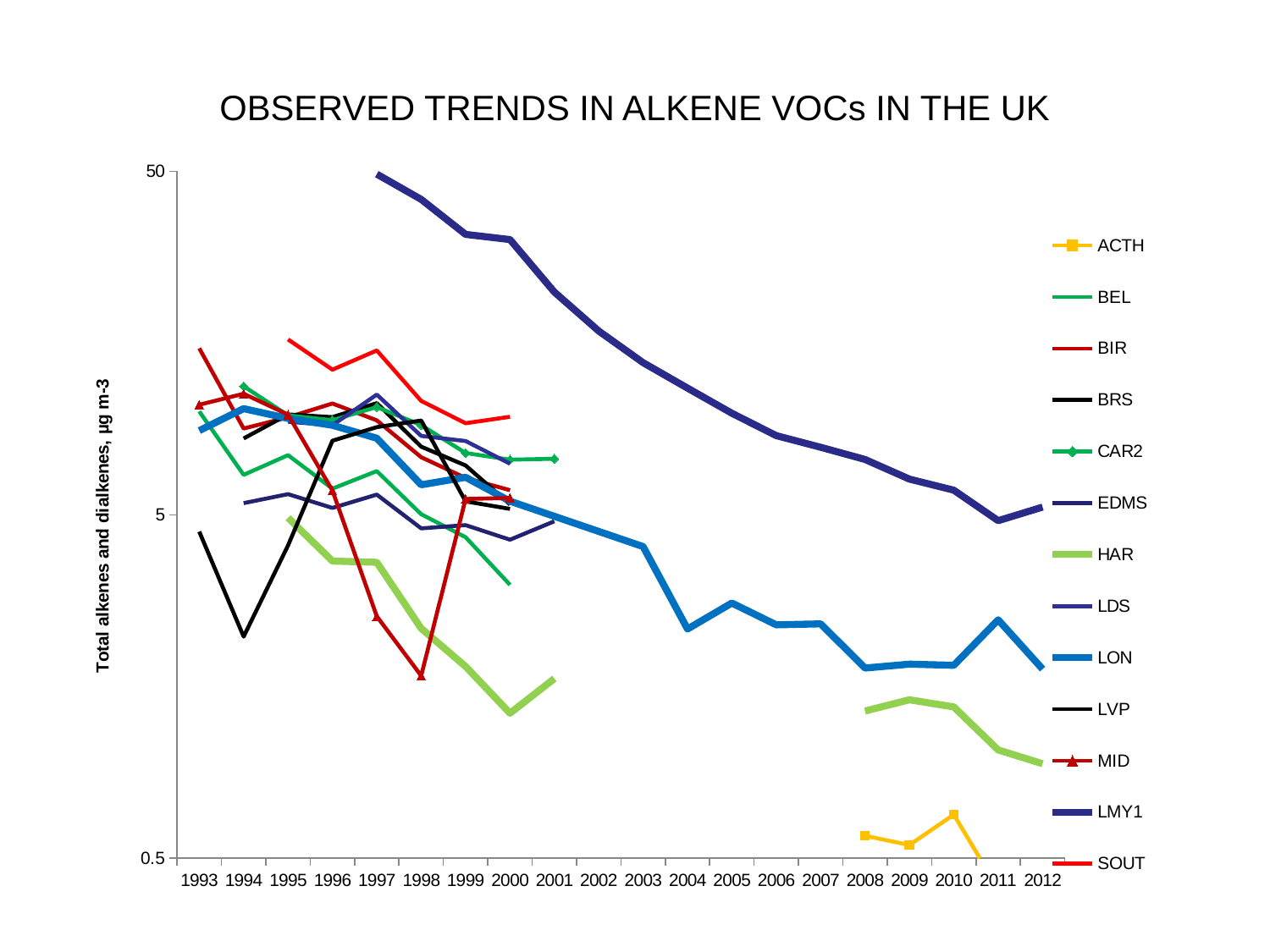
Does the LMY1 series rise or fall from 1997 to 2012? fall Is the value for LON in 2012 greater or less than 5? less Is the value for LMY1 in 2003 greater or less than 5? greater What kind of chart is shown on the slide? line chart How many series does the legend list? 13 What is the label on the y axis? Total alkenes and dialkenes, µg m-3 How many years are labelled along the x axis? 20 Is the value for HAR in 2000 greater or less than 5? less Which series has the highest value in 1997? LMY1 Which series has the lowest value in 2009? ACTH What is the title of the chart? OBSERVED TRENDS IN ALKENE VOCs IN THE UK